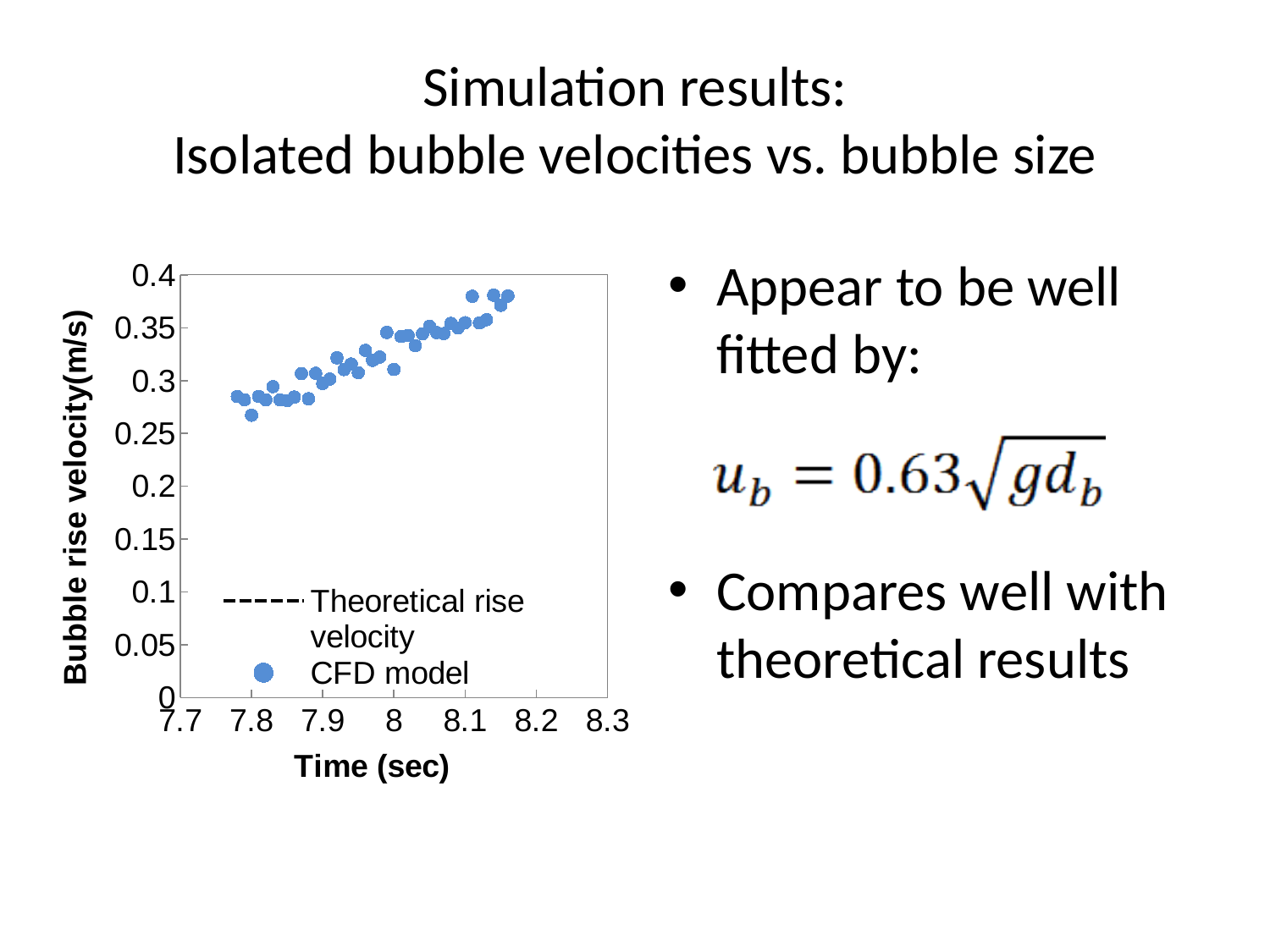
What are the two entries listed in the chart legend? Theoretical rise velocity and CFD model Are the CFD model values near time 7.8 sec greater or less than 0.35 m/s? less Are all the CFD model values greater or less than 0.4 m/s? less Do the CFD model values rise or fall as time increases along the x axis? rise What kind of chart is shown on the slide? scatter chart Are all the CFD model values greater or less than 0.25 m/s? greater What is the label of the x axis of the chart? Time (sec) How many series does the chart legend list? 2